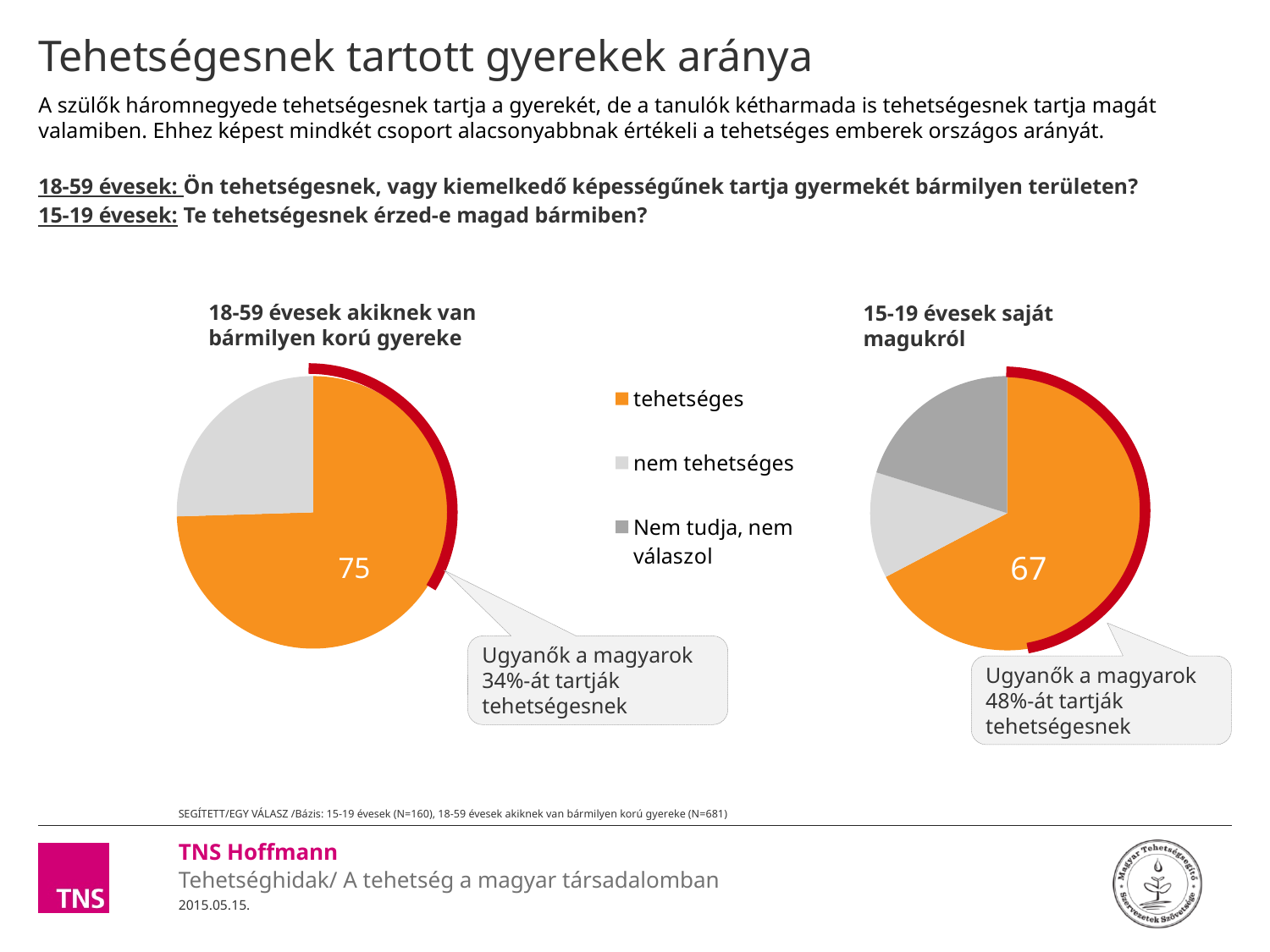
In the right pie chart (15-19 évesek), which category has the largest slice? tehetséges What share of the left pie chart (18-59 évesek) does the 'tehetséges' slice represent? 75 What is the title of the right pie chart? 15-19 évesek saját magukról In the left pie chart (18-59 évesek), which category has the largest slice? tehetséges What is the difference between the 'tehetséges' value in the left pie chart and the 'tehetséges' value in the right pie chart? 8 How many slices does the right pie chart (15-19 évesek saját magukról) have? 3 What type of chart is used on this slide? Pie chart In the left pie chart (18-59 évesek akiknek van bármilyen korú gyereke), what value is shown for the 'tehetséges' slice? 75 Which colour represents 'tehetséges' in the legend? Orange In the right pie chart (15-19 évesek saját magukról), what value is shown for the 'tehetséges' slice? 67 Which chart has the larger 'tehetséges' value, the left one (18-59 évesek) or the right one (15-19 évesek)? The left one (18-59 évesek) How many entries does the legend list? 3